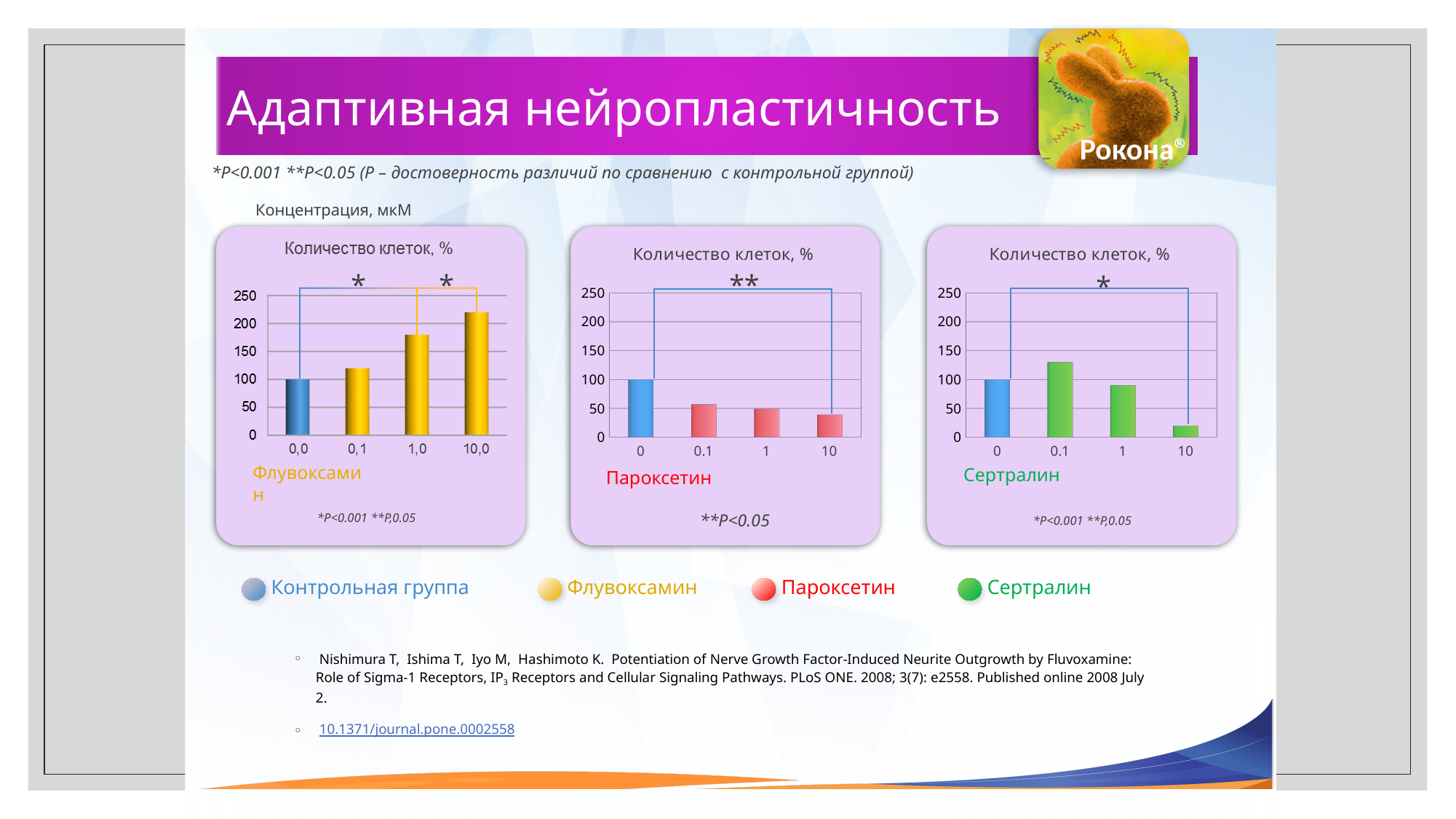
What kind of chart is the Флувоксамин chart (left)? bar chart In the Флувоксамин chart (left), is the value for concentration 1,0 greater or less than 150? greater In the Флувоксамин chart (left), which concentration has the highest bar? 10,0 In the Флувоксамин chart (left), how many concentration categories are shown on the x axis? 4 In the Сертралин chart (right), is the value for concentration 10 greater or less than 50? less In the Сертралин chart (right), which is larger, the value for concentration 1 or for concentration 10? 1 In the Пароксетин chart (middle), which concentration has the lowest bar? 10 In the Флувоксамин chart (left), do the bars rise or fall as concentration increases along the x axis? rise In the Пароксетин chart (middle), is the value for concentration 0.1 greater or less than 100? less In the Сертралин chart (right), which concentration has the highest bar? 0.1 How many entries does the legend below the charts list? 4 In the Пароксетин chart (middle), do the bars rise or fall as concentration increases along the x axis? fall